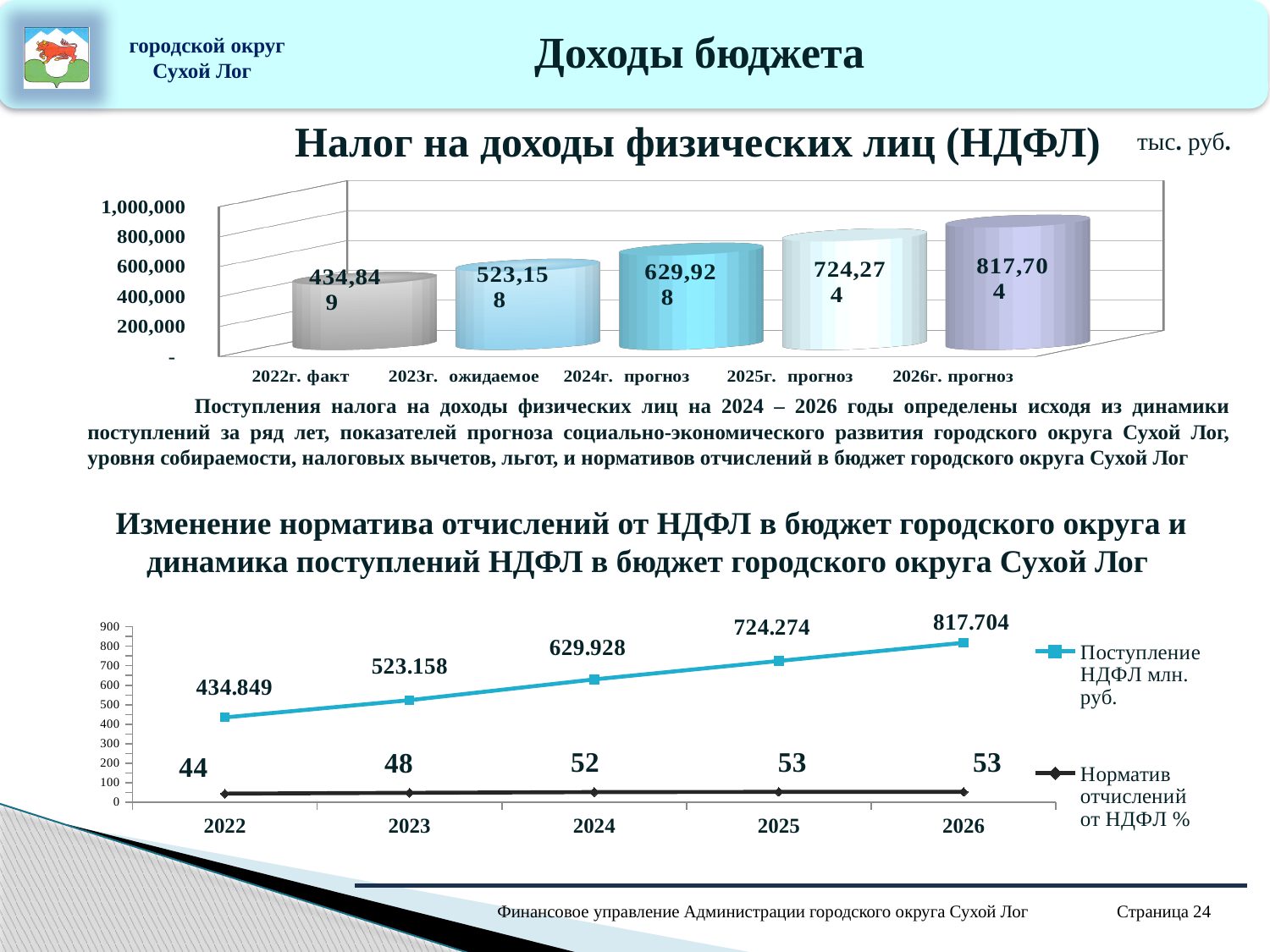
In the bottom chart (Изменение норматива отчислений от НДФЛ), what is the Норматив отчислений от НДФЛ % value for 2023? 48 In the bottom chart (Изменение норматива отчислений от НДФЛ), which is larger: the Норматив отчислений от НДФЛ % value for 2022 or for 2024? 2024 In the top chart (Налог на доходы физических лиц), do the values rise or fall from 2022 to 2026? rise In the top chart (Налог на доходы физических лиц), what is the difference between the 2026г. прогноз and 2025г. прогноз values? 93,430 In the top chart (Налог на доходы физических лиц), what is the value for 2026г. прогноз? 817,704 In the top chart (Налог на доходы физических лиц), which category has the lowest value? 2022г. факт In the top chart (Налог на доходы физических лиц), what is the value for 2022г. факт? 434,849 In the bottom chart (Изменение норматива отчислений от НДФЛ), how many series does the legend list? 2 In the bottom chart (Изменение норматива отчислений от НДФЛ), what kind of chart is it? line chart In the top chart (Налог на доходы физических лиц), how many bars are shown? 5 In the bottom chart (Изменение норматива отчислений от НДФЛ), what is the difference between the Норматив отчислений от НДФЛ % values for 2026 and 2022? 9 In the bottom chart (Изменение норматива отчислений от НДФЛ), what is the Поступление НДФЛ value for 2024? 629.928